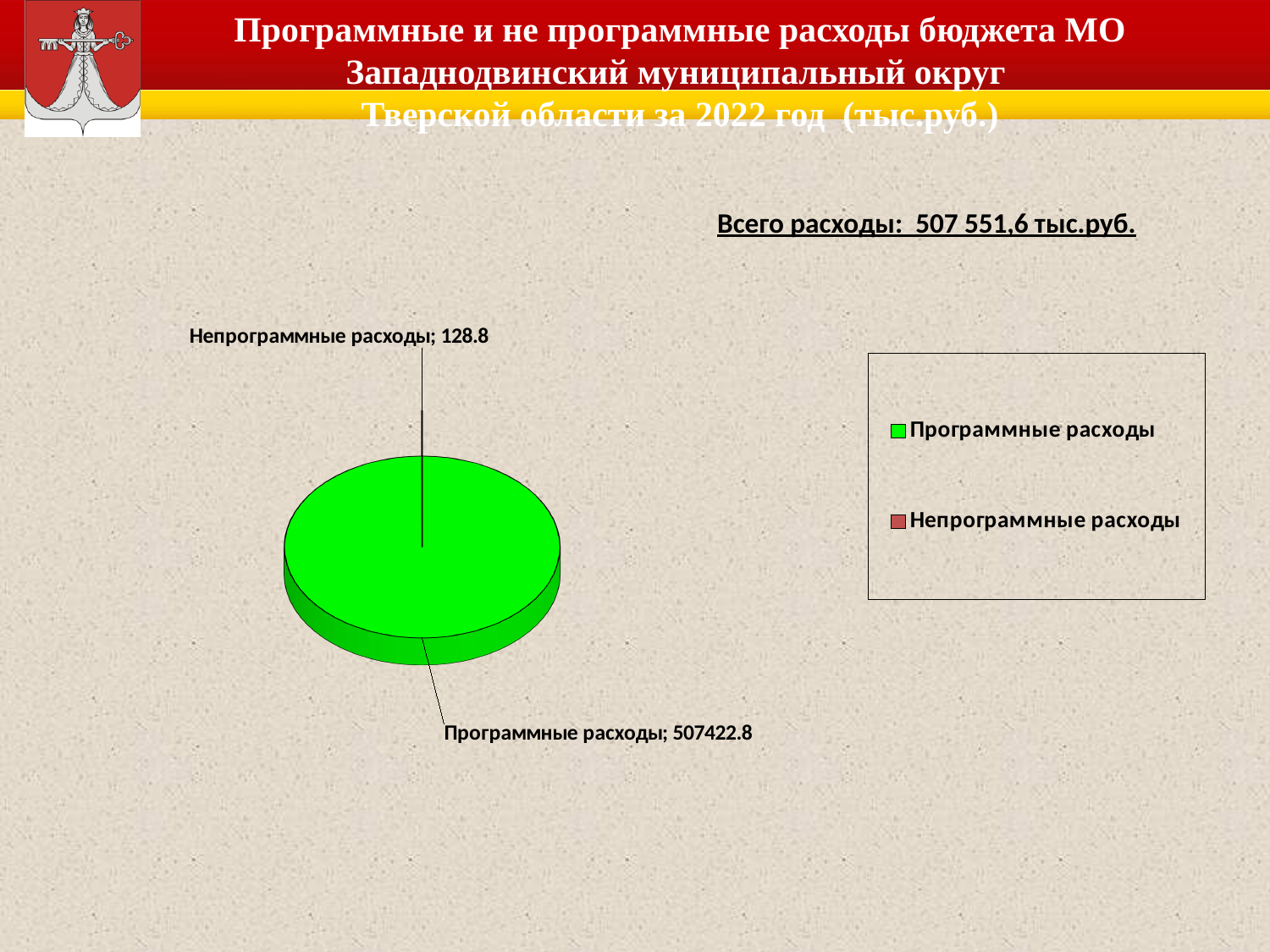
What is the value for Непрограммные расходы in the pie chart? 128.8 How many entries does the legend list? 2 What is the total of the two values shown in the pie chart? 507551.6 What colour is the Программные расходы slice in the pie chart? Green What is the difference between the values for Программные расходы and Непрограммные расходы? 507294.0 What total expenditure figure is stated on the slide above the chart? 507 551,6 тыс.руб. Which category has the largest slice in the pie chart? Программные расходы Which category has the smallest slice in the pie chart? Непрограммные расходы Which is larger, Программные расходы or Непрограммные расходы? Программные расходы What kind of chart is shown on the slide? Pie chart What is the value for Программные расходы in the pie chart? 507422.8 How many categories does the pie chart show? 2